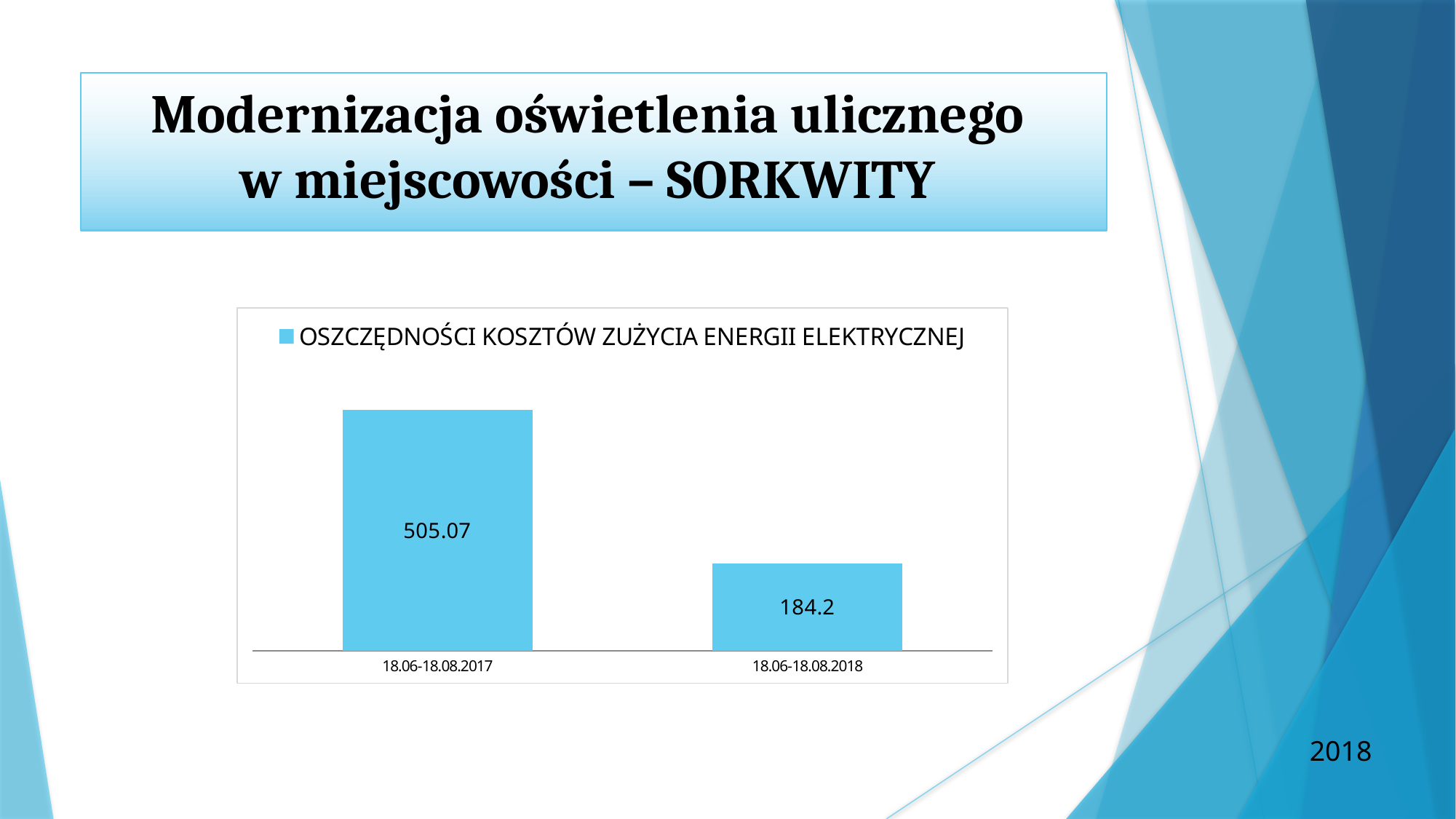
How many categories are shown on the x axis? 2 What is the value for 18.06-18.08.2018? 184.2 Which category has the lowest value? 18.06-18.08.2018 What is the difference between the values for 18.06-18.08.2017 and 18.06-18.08.2018? 320.87 What is the value for 18.06-18.08.2017? 505.07 Which is larger, the value for 18.06-18.08.2017 or for 18.06-18.08.2018? 18.06-18.08.2017 How many series does the legend list? 1 What is the name of the series shown in the legend? OSZCZĘDNOŚCI KOSZTÓW ZUŻYCIA ENERGII ELEKTRYCZNEJ Do the values rise or fall from 18.06-18.08.2017 to 18.06-18.08.2018? fall Which category has the highest value? 18.06-18.08.2017 What kind of chart is shown on the slide? bar chart What colour are the bars in the chart? light blue